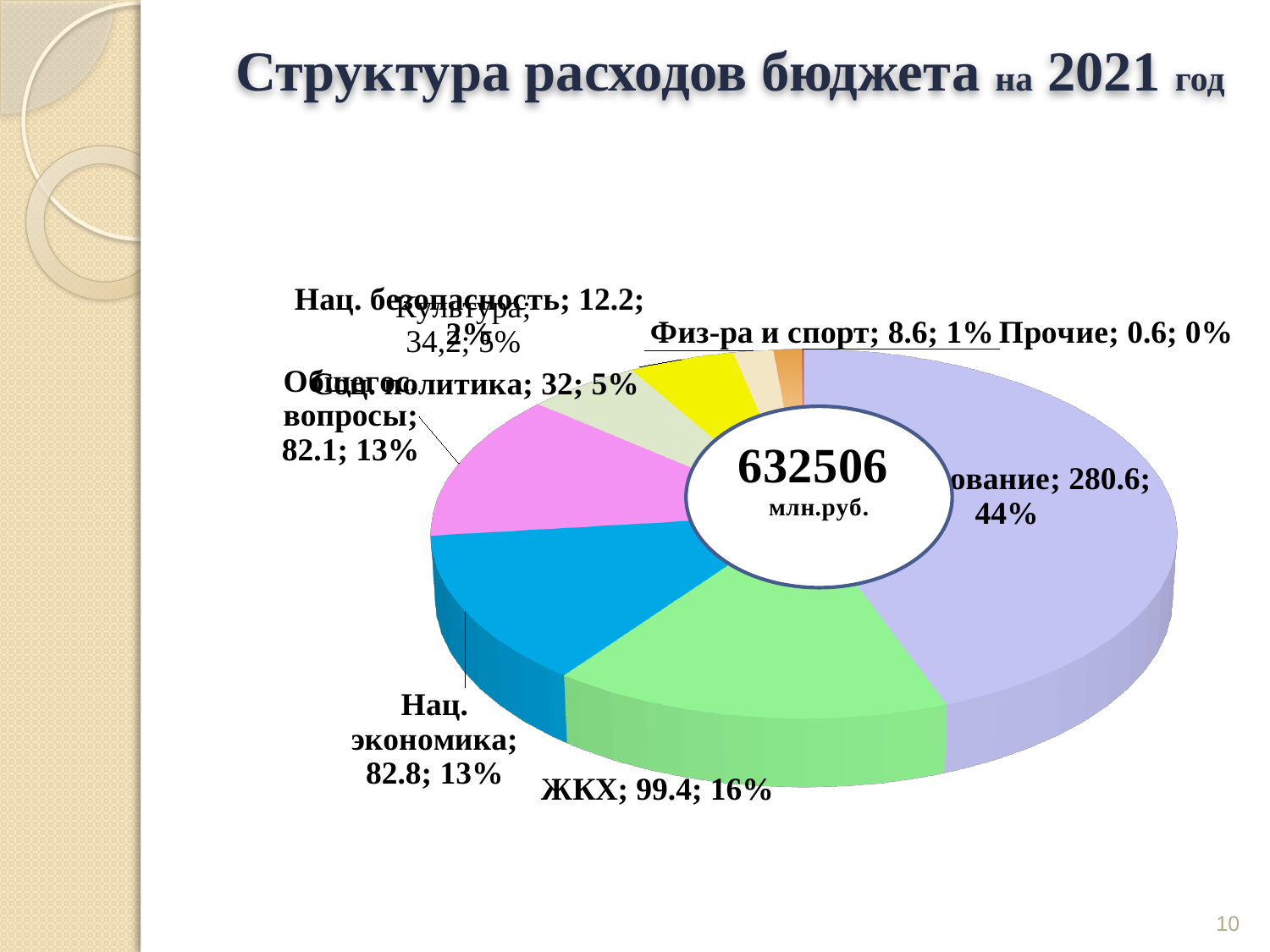
What number is printed in the centre of the pie chart? 632506 What share of the pie does ЖКХ have? 16% Which category has the smallest slice? Прочие What value is shown for ЖКХ? 99.4 What share of the pie does Физ-ра и спорт have? 1% What is the difference between the values for ЖКХ and Нац. экономика? 16.6 What value is shown for Нац. экономика? 82.8 What share of the pie does the largest slice have? 44% What value is shown for Соц. политика? 32 What kind of chart is shown on the slide? pie chart Which is larger, the value for Нац. экономика or for Общегос. вопросы? Нац. экономика What value is shown for Физ-ра и спорт? 8.6